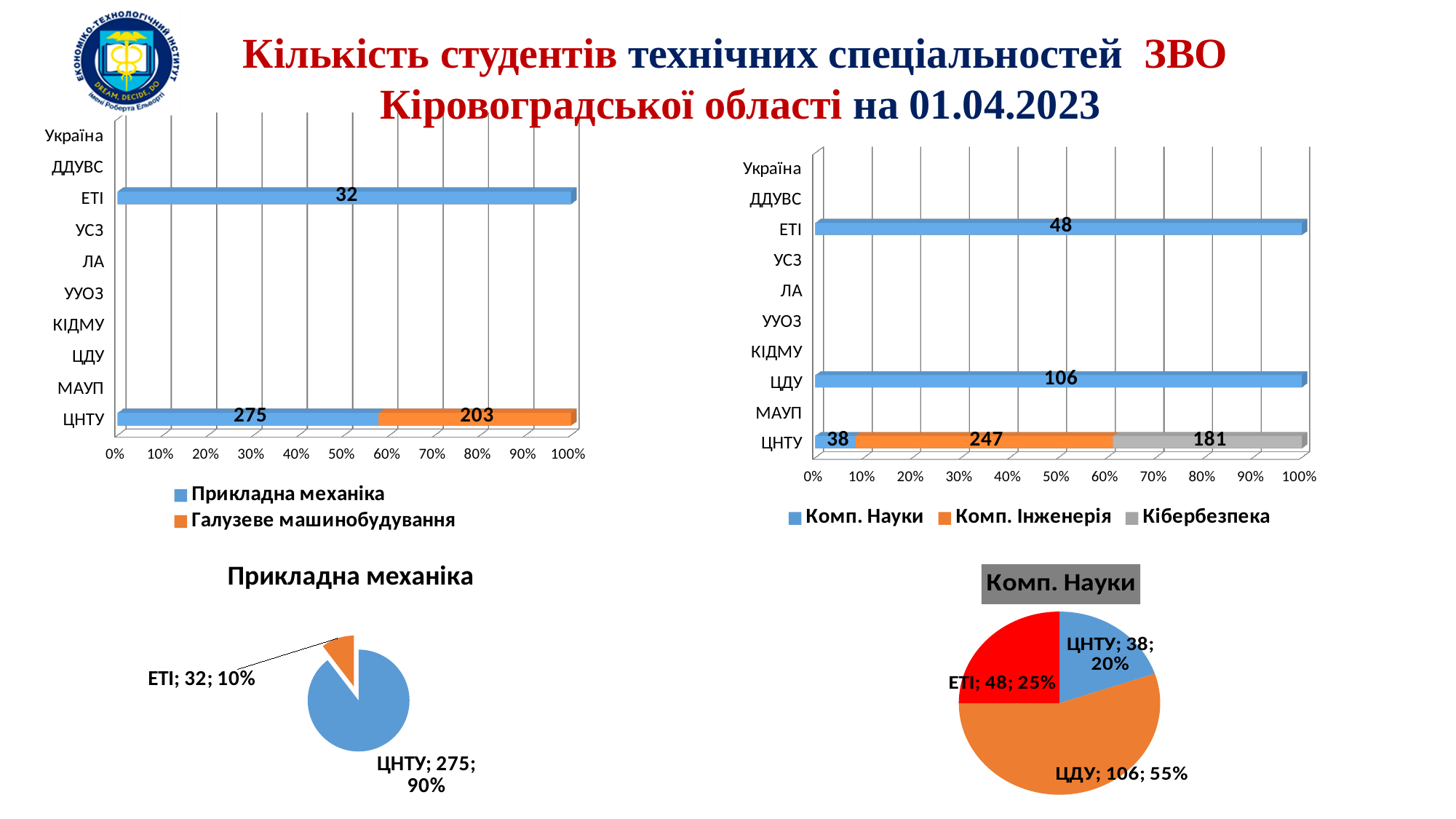
How many series does the legend of the top-right bar chart list? 3 In the top-left bar chart, what is the value of Прикладна механіка for ЕТІ? 32 In the top-left bar chart, what is the value of Прикладна механіка for ЦНТУ? 275 In the top-left bar chart, what is the total of the stacked bar for ЦНТУ? 478 In the top-right bar chart, what is the difference between Комп. Інженерія and Комп. Науки for ЦНТУ? 209 In the top-right bar chart, what is the value of Кібербезпека for ЦНТУ? 181 In the pie chart titled Прикладна механіка, which institution has the largest slice? ЦНТУ How many series does the legend of the top-left bar chart list? 2 In the top-left bar chart, what is the value of Галузеве машинобудування for ЦНТУ? 203 In the top-right bar chart, what is the value of Комп. Науки for ЦДУ? 106 What type of chart is the bottom-right chart titled Комп. Науки? pie chart In the pie chart titled Комп. Науки, what share does ЦДУ have? 55%